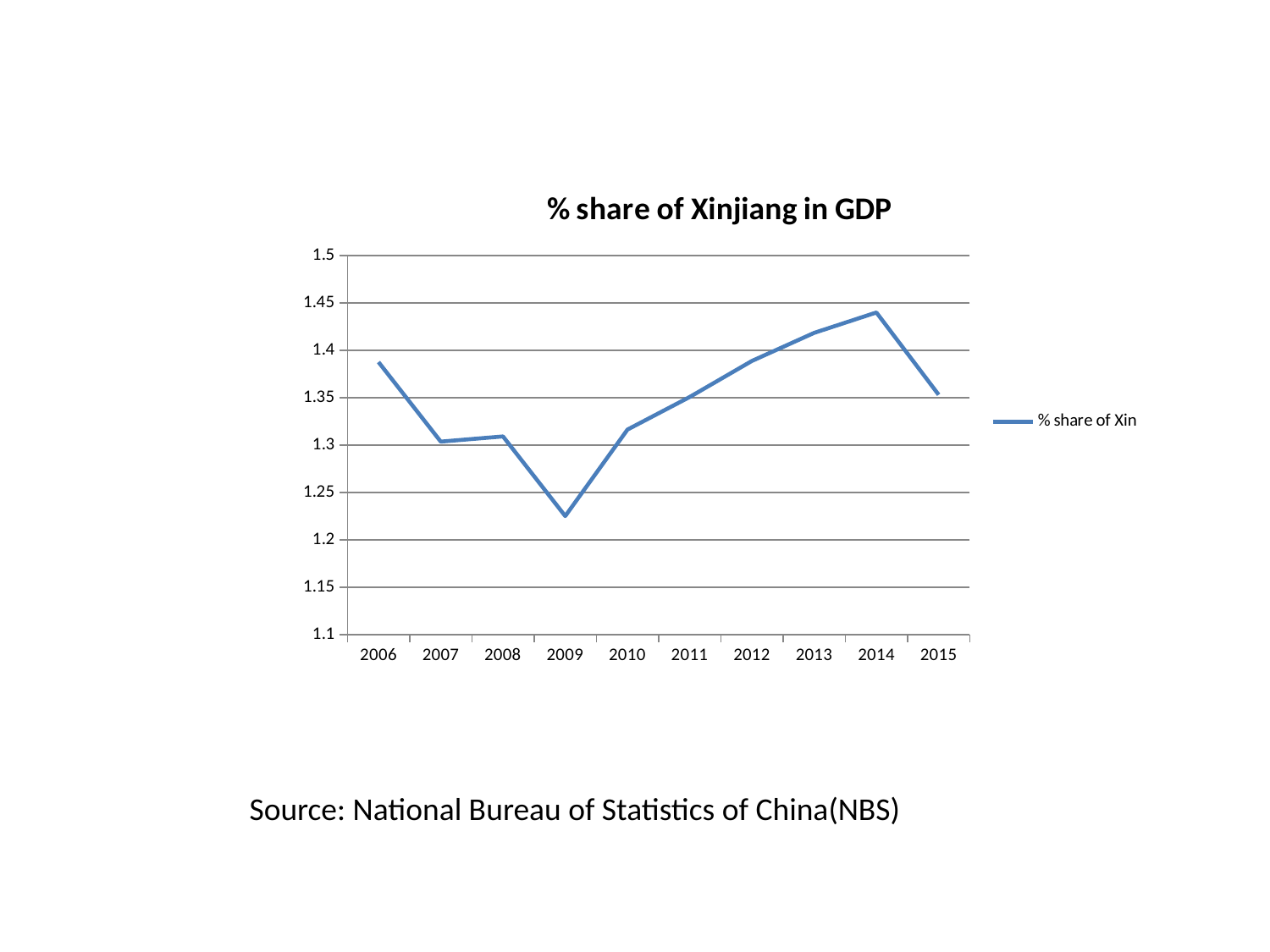
Which year has the lowest % share of Xinjiang in GDP? 2009 Is the value for 2009 greater or less than 1.25? less How many series does the legend list? 1 Is the value for 2006 greater or less than 1.4? less Which year has the larger value, 2010 or 2013? 2013 How many years are plotted along the x axis? 10 Which year has the larger value, 2006 or 2007? 2006 Which year has the highest % share of Xinjiang in GDP? 2014 Does the % share of Xinjiang in GDP rise or fall from 2009 to 2014? rise Is the value for 2014 greater or less than 1.4? greater What kind of chart is shown on the slide? line chart What is the title of the chart? % share of Xinjiang in GDP